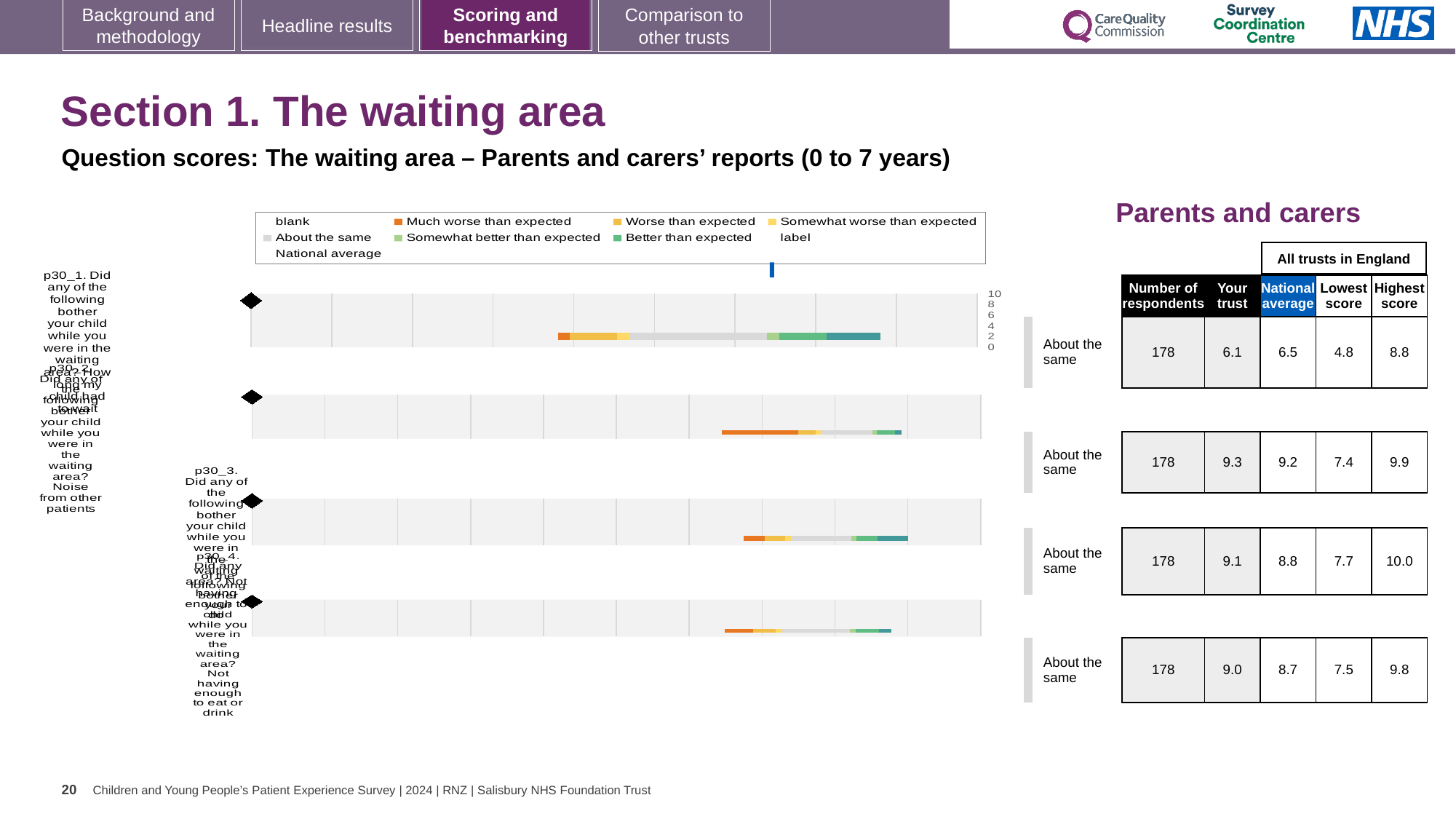
How many respondents are listed for question p30_1 (noise from other patients) in the table? 178 For question p30_1, what is the difference between the national average (6.5) and the trust's score (6.1)? 0.4 What is the highest score across all trusts in England for question p30_4 (not having enough to eat or drink)? 9.8 What is the national average score for question p30_3 (not having enough to do)? 8.8 What benchmark category is shown next to each of the four questions? About the same What is the 'Your trust' score for question p30_2 (how long my child had to wait)? 9.3 What kind of chart is used to show the question scores? Bar chart How many questions are plotted in the chart? 4 For question p30_2, which is larger: the trust's score or the national average? Your trust (9.3) What is the lowest score across all trusts in England for question p30_1 (noise from other patients)? 4.8 Which question has the highest 'Your trust' score? p30_2 (how long my child had to wait), 9.3 Which question has the lowest 'Your trust' score? p30_1 (noise from other patients), 6.1